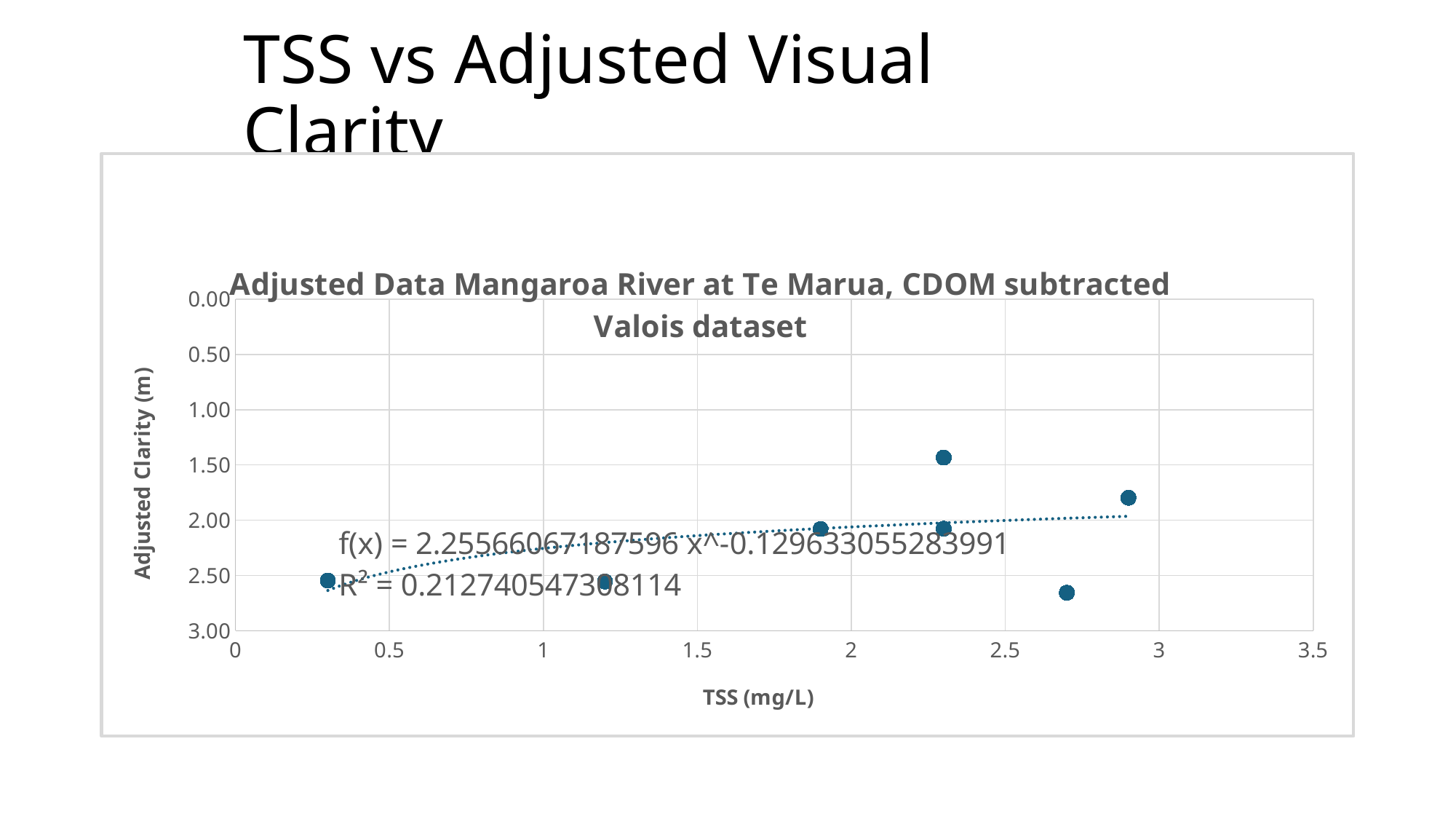
Is the adjusted clarity value for the upper point at TSS 2.3 greater or less than 1.50? less How many data points are plotted in the chart? 7 Is the adjusted clarity value for the point at TSS 2.9 greater or less than 2.00? less Is the adjusted clarity value for the point at TSS 2.9 greater or less than 1.50? greater What is the title of the chart? Adjusted Data Mangaroa River at Te Marua, CDOM subtracted Valois dataset What trendline equation is printed on the chart? f(x) = 2.25566067187596 x^-0.129633055283991 At which TSS value is the point with the smallest adjusted clarity value? 2.3 What R² value is printed on the chart? 0.212740547308114 What kind of chart is shown on the slide? scatter chart What is the label of the x axis? TSS (mg/L) What is the highest tick value shown on the x axis? 3.5